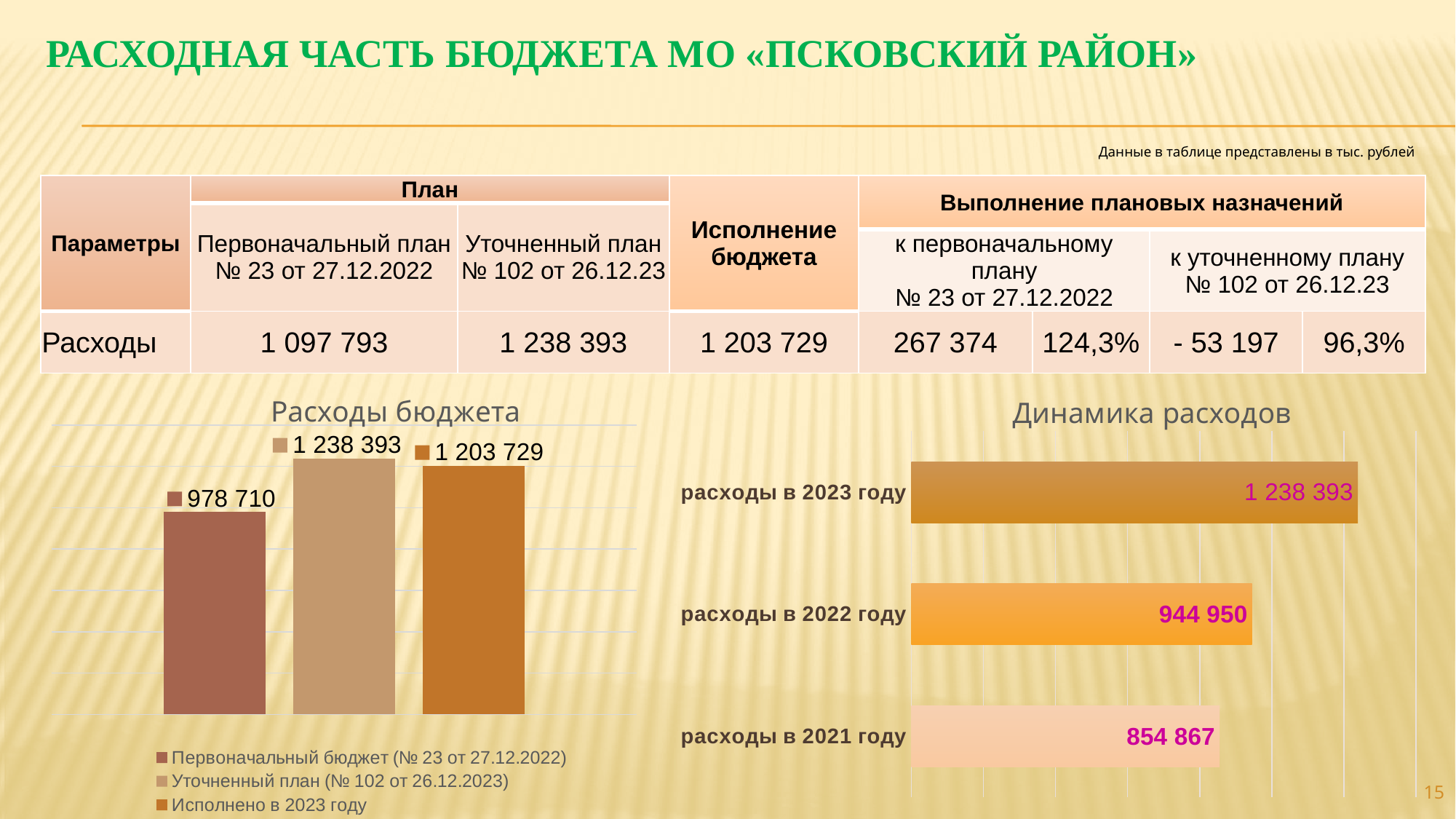
In the 'Расходы бюджета' chart, what value is shown for 'Уточненный план (№ 102 от 26.12.2023)'? 1 238 393 In the 'Расходы бюджета' chart, what is the difference between 'Уточненный план' and 'Исполнено в 2023 году'? 34 664 In the 'Расходы бюджета' chart, which series has the lowest value? Первоначальный бюджет (№ 23 от 27.12.2022) What kind of chart is 'Динамика расходов'? Bar chart How many series does the legend of the 'Расходы бюджета' chart list? 3 In the 'Расходы бюджета' chart, what value is shown for 'Первоначальный бюджет (№ 23 от 27.12.2022)'? 978 710 In the 'Динамика расходов' chart, what is the value for 'расходы в 2021 году'? 854 867 In the 'Динамика расходов' chart, do expenses rise or fall from 2021 to 2023? Rise In the 'Динамика расходов' chart, what is the value for 'расходы в 2022 году'? 944 950 In the 'Динамика расходов' chart, what is the difference between expenses in 2022 and 2021? 90 083 In the 'Расходы бюджета' chart, what value is shown for 'Исполнено в 2023 году'? 1 203 729 In the 'Динамика расходов' chart, which year has the highest expenses? расходы в 2023 году